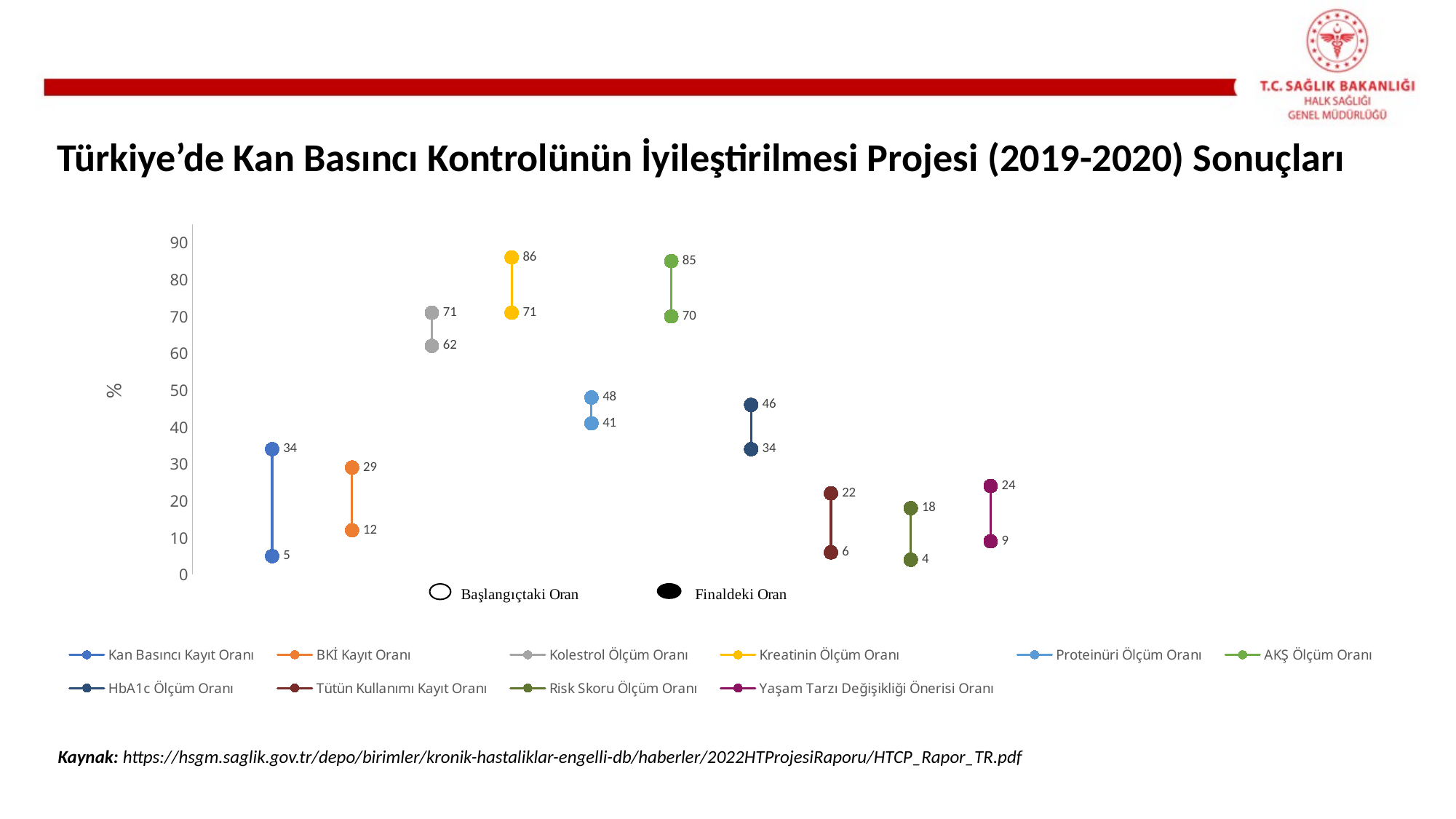
What is the higher value plotted for Tütün Kullanımı Kayıt Oranı? 22 Which series has the highest plotted value on the chart? Kreatinin Ölçüm Oranı How many series does the legend list? 10 What kind of chart is shown on the slide? Line chart with markers What are the two values plotted for Kolestrol Ölçüm Oranı? 62 and 71 What is the difference between the two values plotted for BKİ Kayıt Oranı? 17 What is the higher of the two values plotted for Kreatinin Ölçüm Oranı? 86 What is the lower of the two values plotted for Kan Basıncı Kayıt Oranı? 5 What label is shown on the vertical axis of the chart? % Which is larger: the higher value for HbA1c Ölçüm Oranı or the higher value for Proteinüri Ölçüm Oranı? Proteinüri Ölçüm Oranı Which series has the lowest plotted value on the chart? Risk Skoru Ölçüm Oranı What is the difference between the two values plotted for AKŞ Ölçüm Oranı? 15